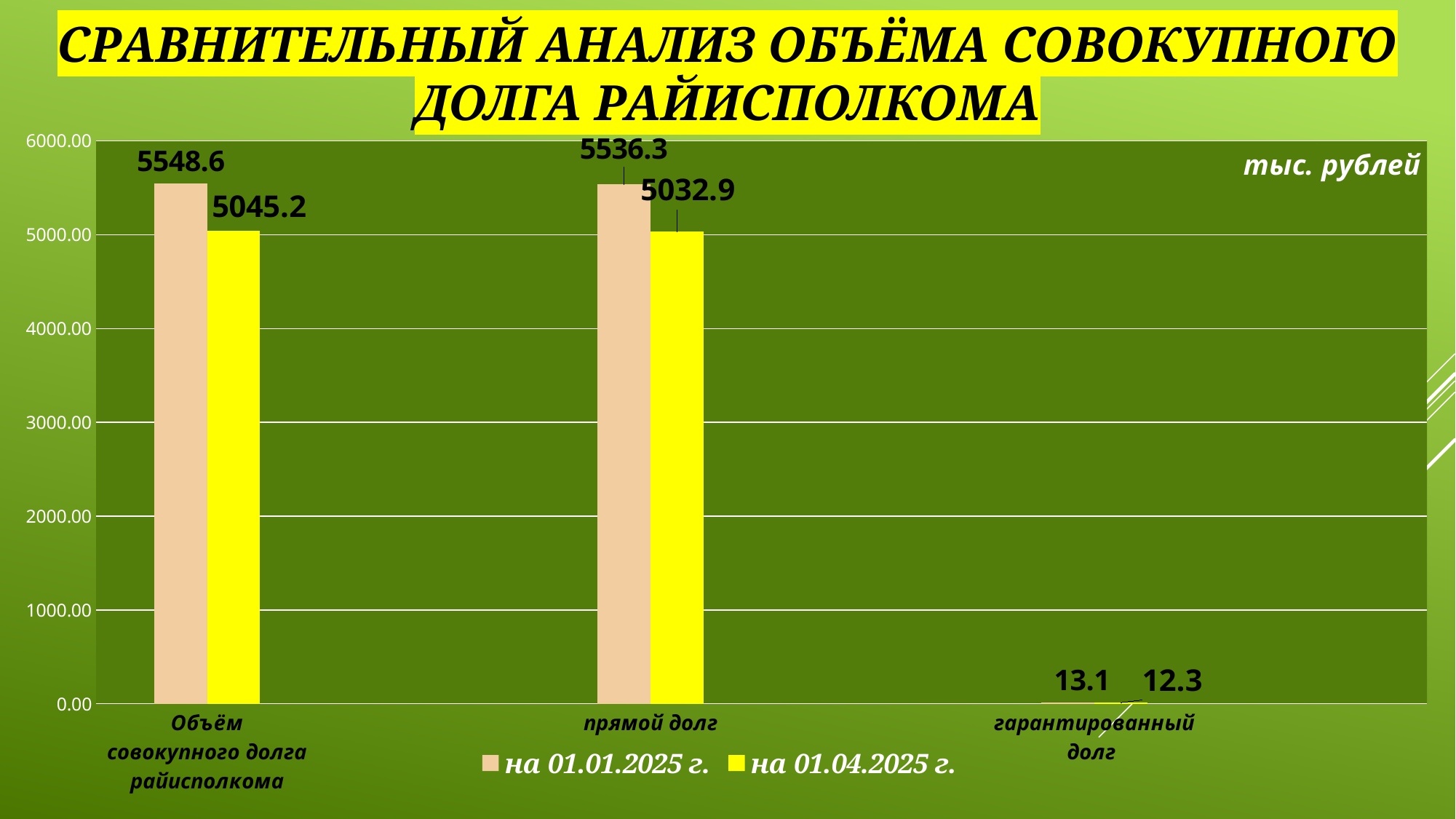
What is the value for "прямой долг" in the "на 01.01.2025 г." series? 5536.3 What is the value for "гарантированный долг" in the "на 01.01.2025 г." series? 13.1 Which category has the highest value in the "на 01.01.2025 г." series? Объём совокупного долга райисполкома How many categories are shown on the x axis? 3 Is the "на 01.04.2025 г." value for "прямой долг" greater or less than 4000.00? greater What is the difference between the "на 01.01.2025 г." and "на 01.04.2025 г." values for "прямой долг"? 503.4 Which is larger for "Объём совокупного долга райисполкома": the value on 01.01.2025 or on 01.04.2025? на 01.01.2025 г. What is the value for "Объём совокупного долга райисполкома" in the "на 01.04.2025 г." series? 5045.2 What type of chart is shown on the slide? bar chart What is the value for "гарантированный долг" in the "на 01.04.2025 г." series? 12.3 How many series does the legend list? 2 Which category has the lowest value in the "на 01.04.2025 г." series? гарантированный долг